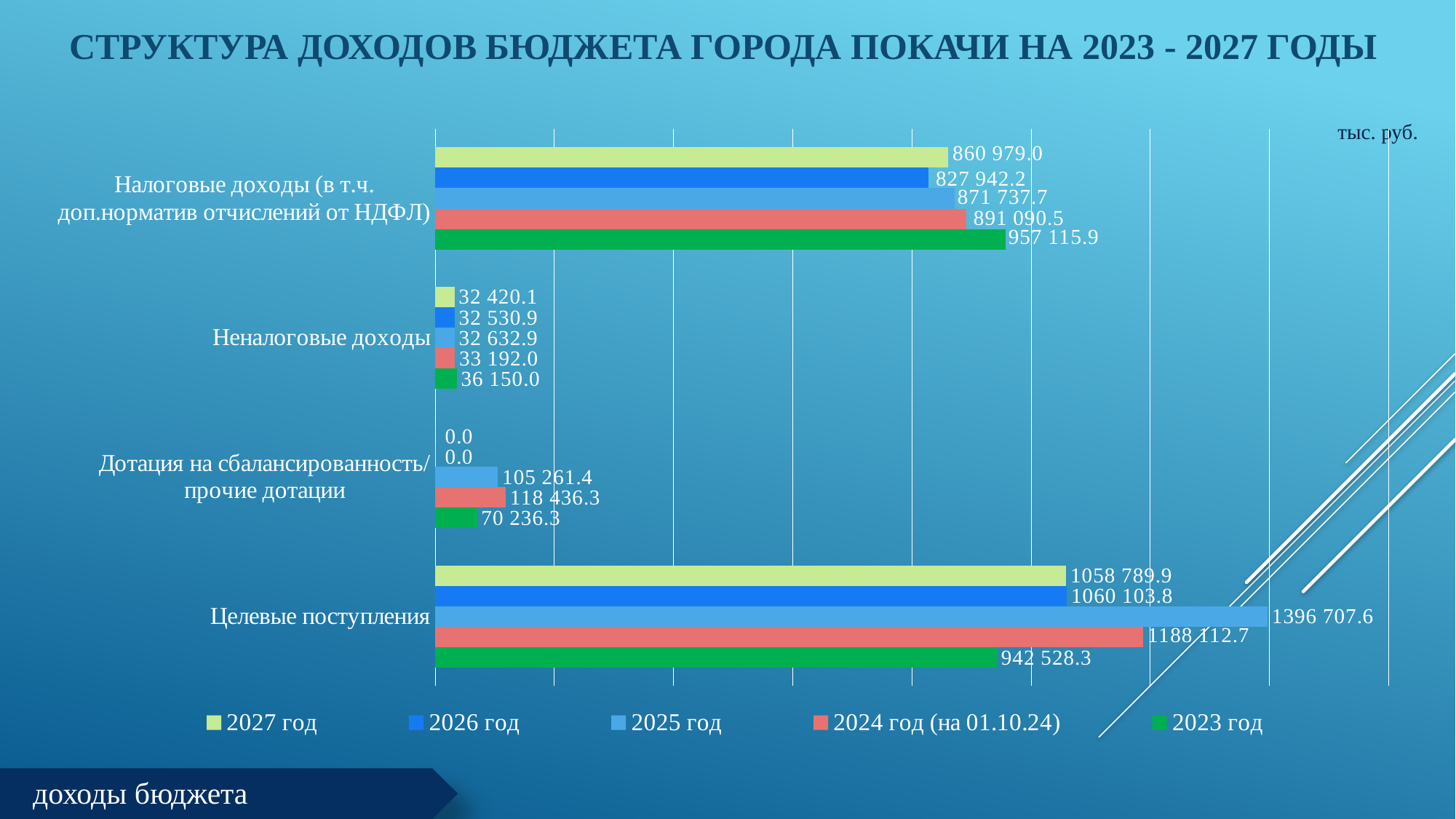
Which year series has the lowest value for Целевые поступления? 2023 год How many series does the legend list? 5 What is the difference between the 2025 год and 2024 год (на 01.10.24) values for Целевые поступления? 208 594.9 What is the difference between the 2024 год (на 01.10.24) and 2025 год values for Дотация на сбалансированность/прочие дотации? 13 174.9 Which is larger for Налоговые доходы: the 2026 год value or the 2025 год value? 2025 год What kind of chart is shown on the slide? Bar chart How many categories are shown on the chart? 4 Which year series has the highest value for Налоговые доходы? 2023 год What is the value for Дотация на сбалансированность/прочие дотации in the 2027 год series? 0.0 What is the value for Целевые поступления in the 2025 год series? 1396 707.6 What is the value for Неналоговые доходы in the 2024 год (на 01.10.24) series? 33 192.0 What is the value for Налоговые доходы in the 2023 год series? 957 115.9